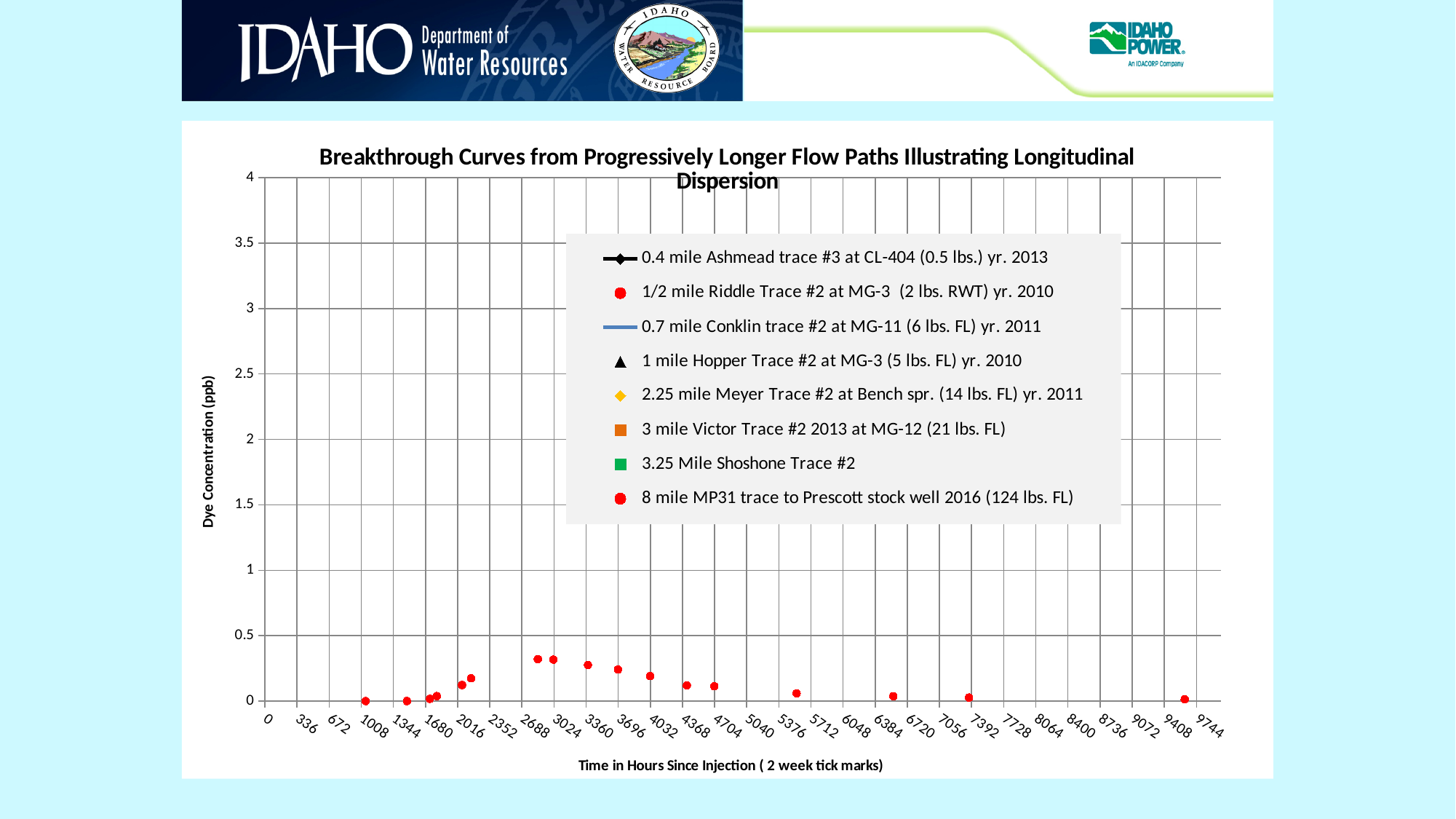
Do the plotted values rise or fall along the x axis between about 3024 and 4704 hours? fall What is the label of the y axis? Dye Concentration (ppb) How many series does the legend list? 8 Is the plotted value at about 9408 hours greater or less than 0.5? less What is the title of the chart? Breakthrough Curves from Progressively Longer Flow Paths Illustrating Longitudinal Dispersion What kind of chart is shown on the slide? Scatter chart What is the highest value shown on the y axis? 4 Is the plotted value at about 2688 hours greater or less than 0.5? less Do the plotted values rise or fall along the x axis between about 1008 and 2688 hours? rise